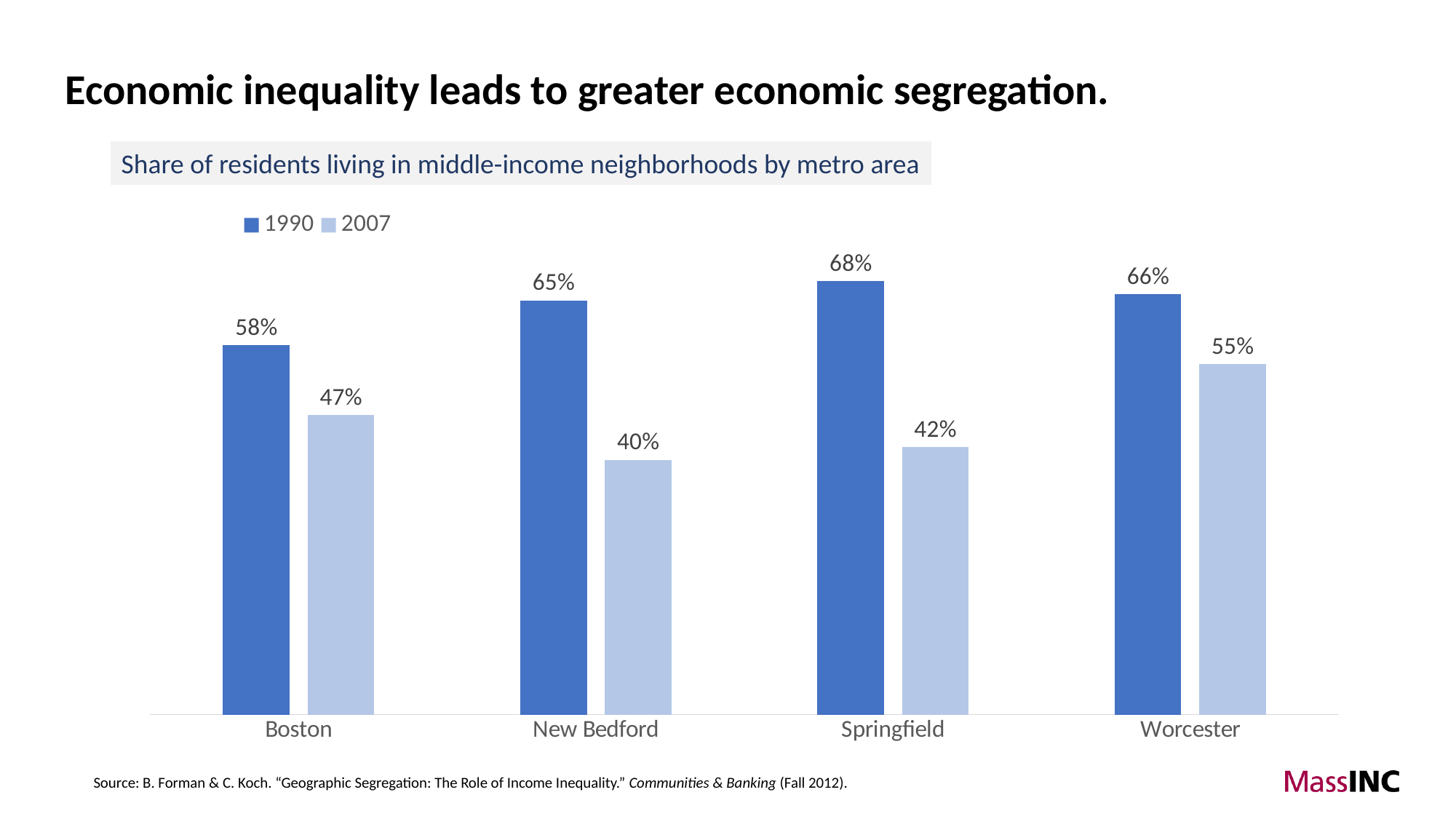
What share of Boston residents lived in middle-income neighborhoods in 1990? 58% What is the title of the chart? Share of residents living in middle-income neighborhoods by metro area What is the 2007 value for New Bedford? 40% How many metro areas are shown on the chart? 4 Which is larger: Boston's 2007 value or Worcester's 2007 value? Worcester's 2007 value By how many percentage points did Springfield's share fall from 1990 to 2007? 26 percentage points Which metro area had the highest share in 1990? Springfield How many series does the legend list? 2 Which metro area had the lowest share in 2007? New Bedford What is the 2007 value for Worcester? 55% What is the difference between Worcester's 1990 and 2007 values? 11 percentage points What kind of chart is shown on the slide? Bar chart